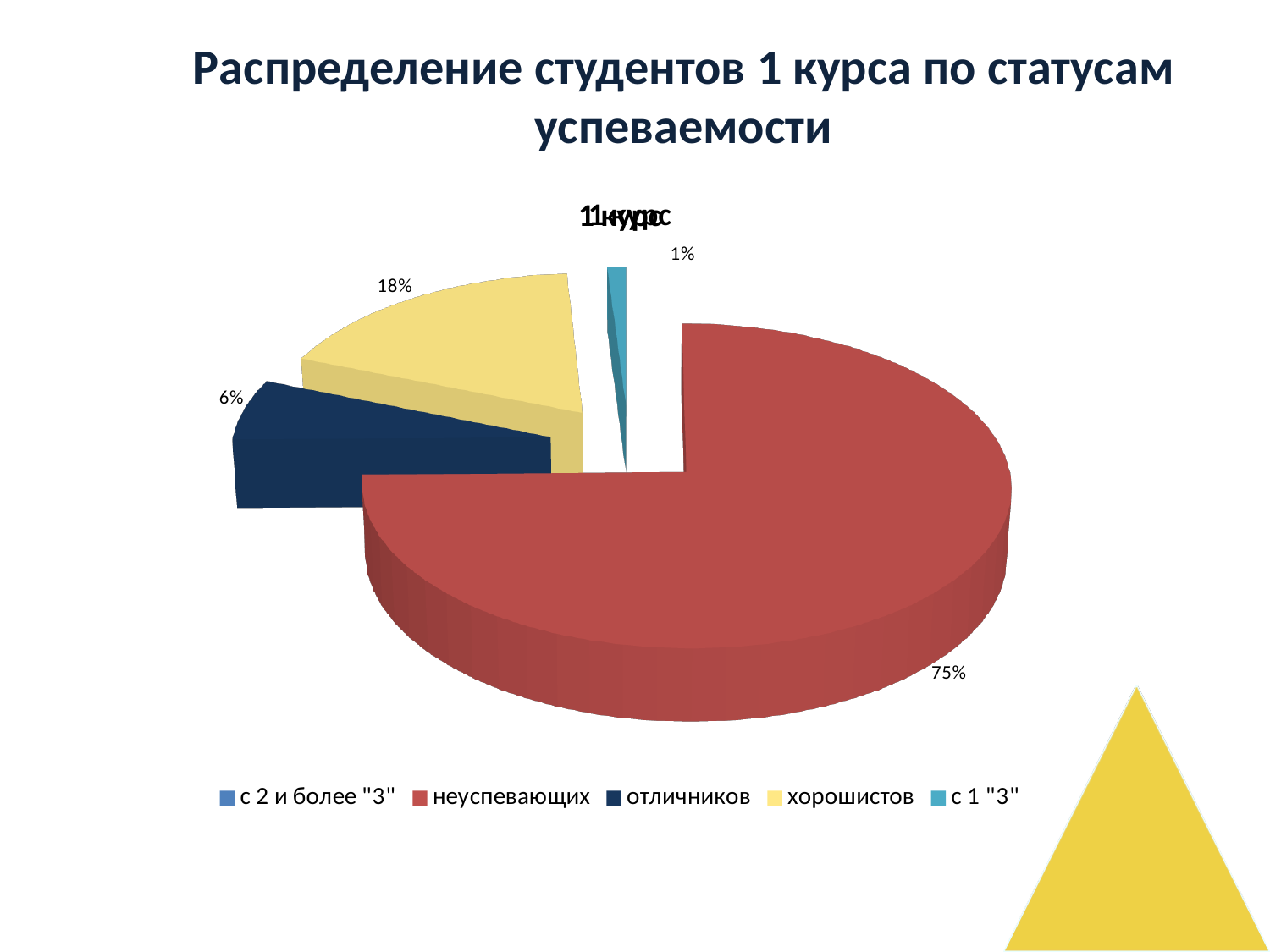
How many entries does the legend of the pie chart list? 5 What colour is the "неуспевающих" slice in the pie chart? red Which labelled slice is the smallest in the pie chart? с 1 "3" What percentage of first-year students are "неуспевающих" according to the pie chart? 75% What share of the pie is labelled for "хорошистов"? 18% What is the title of the slide? Распределение студентов 1 курса по статусам успеваемости What is the difference in percentage points between the "неуспевающих" slice and the "хорошистов" slice? 57 What percentage is shown for "отличников"? 6% Which slice is larger: "хорошистов" or "отличников"? хорошистов What kind of chart is shown on the slide? pie chart What percentage is shown for the "с 1 "3"" slice? 1% Which category has the largest slice of the pie? неуспевающих